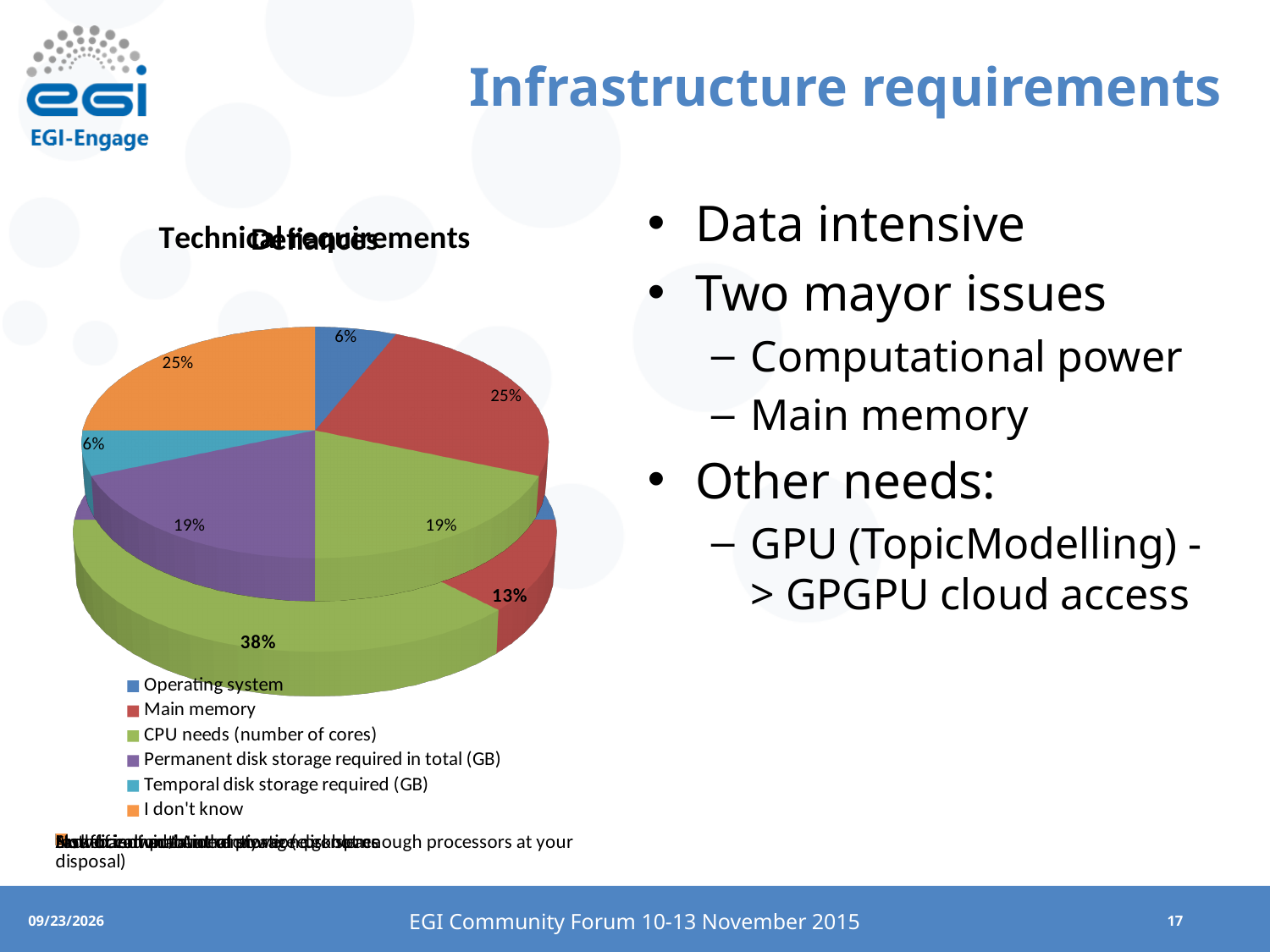
In the front pie chart, what share is shown for Temporal disk storage required (GB)? 6% In the front pie chart, what share is shown for Operating system? 6% In the front pie chart, what share is shown for Permanent disk storage required in total (GB)? 19% How many categories does the legend of the front pie chart list? 6 In the front pie chart, what is the difference between the share for Main memory and the share for Operating system? 19% In the front pie chart, what colour is the slice for CPU needs (number of cores)? Green In the front pie chart, which two categories share the smallest slice? Operating system and Temporal disk storage required (GB) In the front pie chart, what share is shown for I don't know? 25% In the front pie chart, what share is shown for Main memory? 25% In the front pie chart, what share is shown for CPU needs (number of cores)? 19% In the front pie chart, which is larger: the share for Main memory or the share for CPU needs (number of cores)? Main memory What kind of chart is shown on the left of the slide? Pie chart